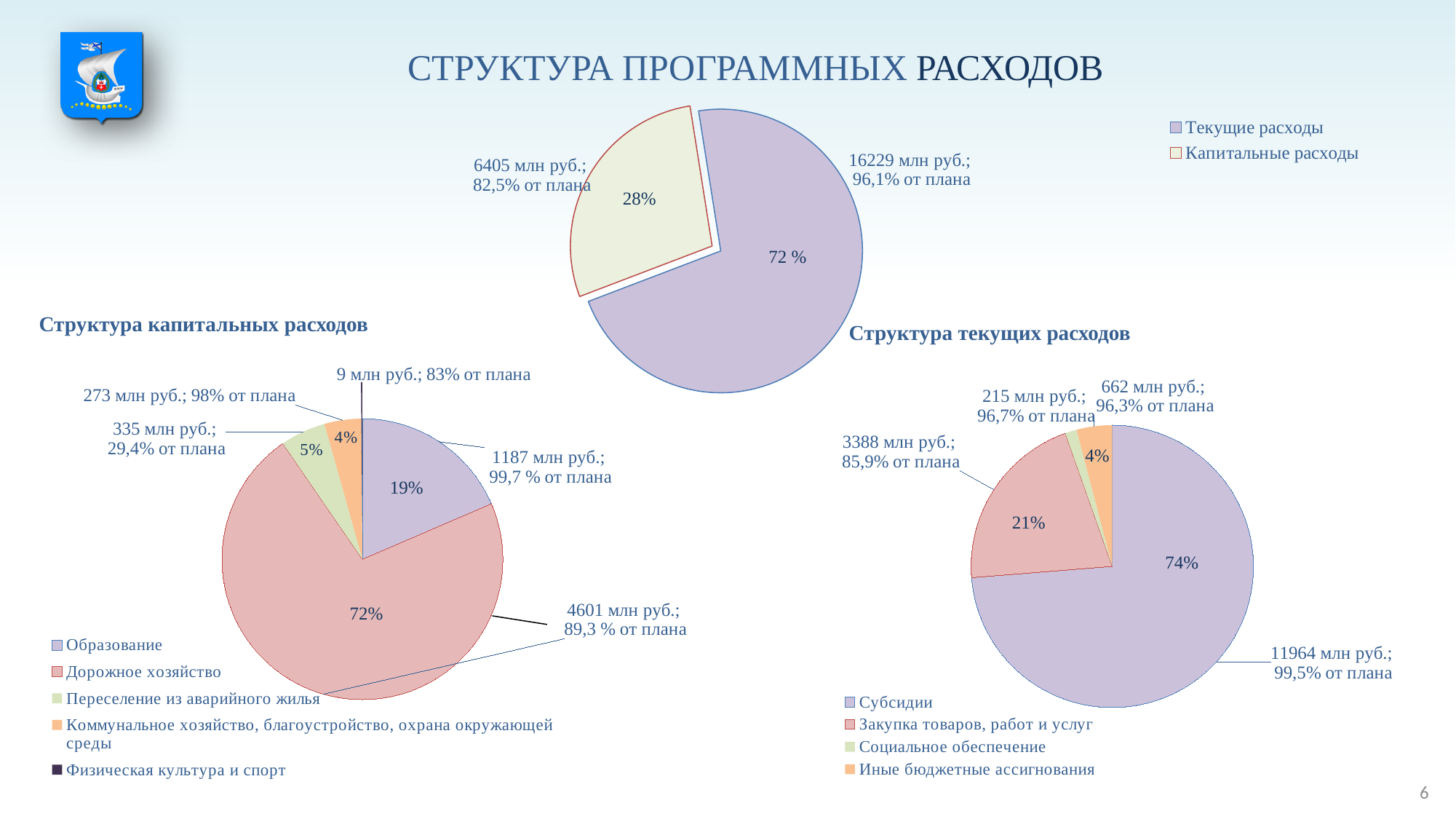
How many categories does the legend of the Структура капитальных расходов chart list? 5 In the Структура текущих расходов chart, what amount is shown for Закупка товаров, работ и услуг? 3388 млн руб. In the top pie chart (Структура программных расходов), what amount is shown for Капитальные расходы? 6405 млн руб. In the Структура капитальных расходов chart, which category has the largest slice? Дорожное хозяйство In the Структура капитальных расходов chart, what share of the pie is Переселение из аварийного жилья? 5% In the Структура текущих расходов chart, which is larger: Субсидии or Закупка товаров, работ и услуг? Субсидии In the top pie chart (Структура программных расходов), what share of the pie is Текущие расходы? 72 % In the Структура капитальных расходов chart, what amount is shown for Образование? 1187 млн руб. How many series does the legend of the top pie chart (Структура программных расходов) list? 2 What kind of chart is used for Структура капитальных расходов? Pie chart In the top pie chart (Структура программных расходов), what percentage of plan is shown for Текущие расходы? 96,1% от плана In the Структура текущих расходов chart, what share of the pie is Субсидии? 74%